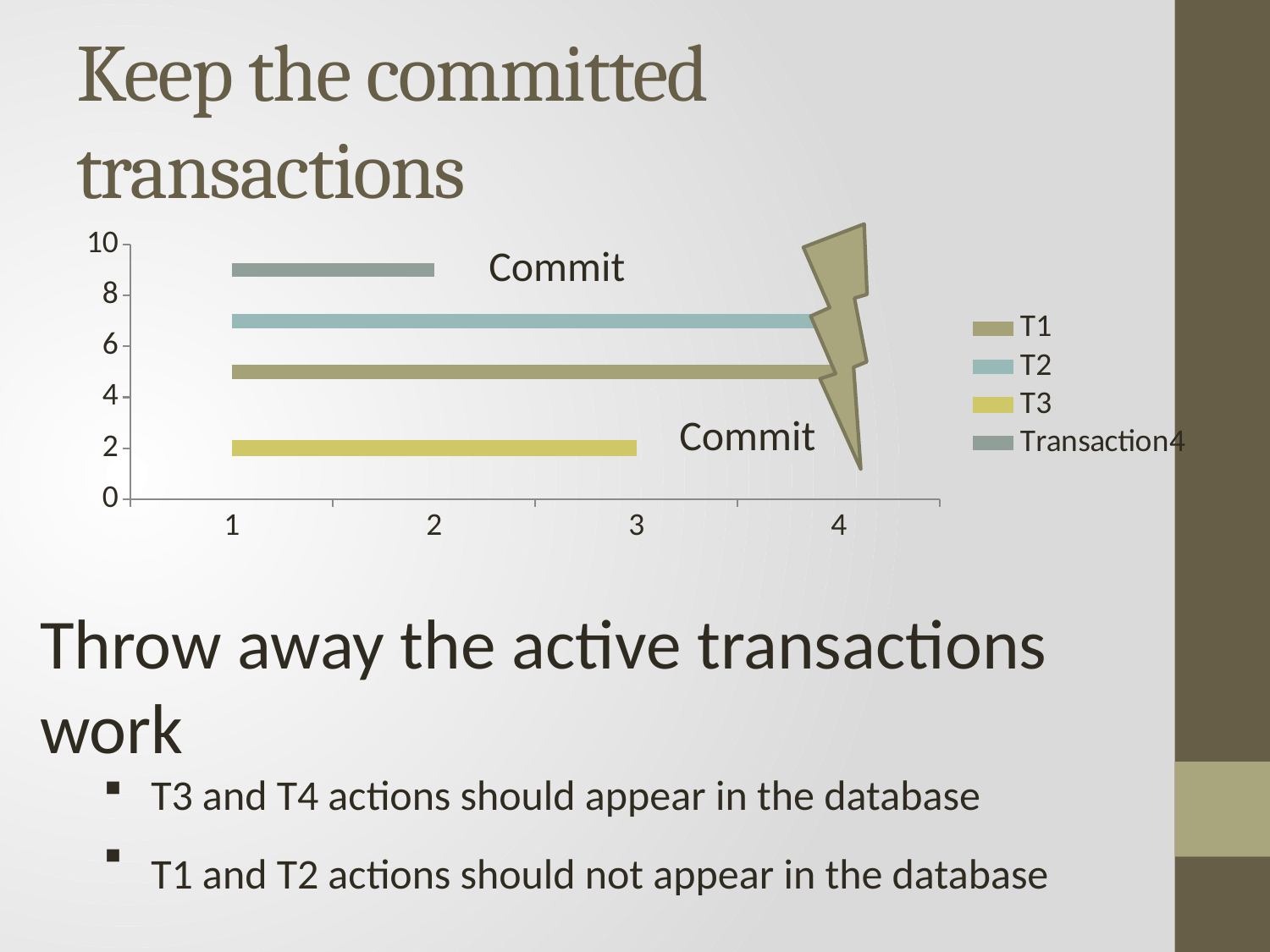
Which series is plotted highest on the y axis? Transaction4 Is the value for T1 greater or less than 6? less Is the value for T2 greater or less than 6? greater Is the value for Transaction4 greater or less than 8? greater Which series is plotted higher, T1 or T2? T2 How many labelled points are there on the x axis? 4 Which series is plotted lowest on the y axis? T3 What are the series names listed in the legend? T1, T2, T3, Transaction4 Does the T1 line rise, fall, or stay flat along the x axis? stay flat How many series does the legend list? 4 What kind of chart is shown on the slide? line chart